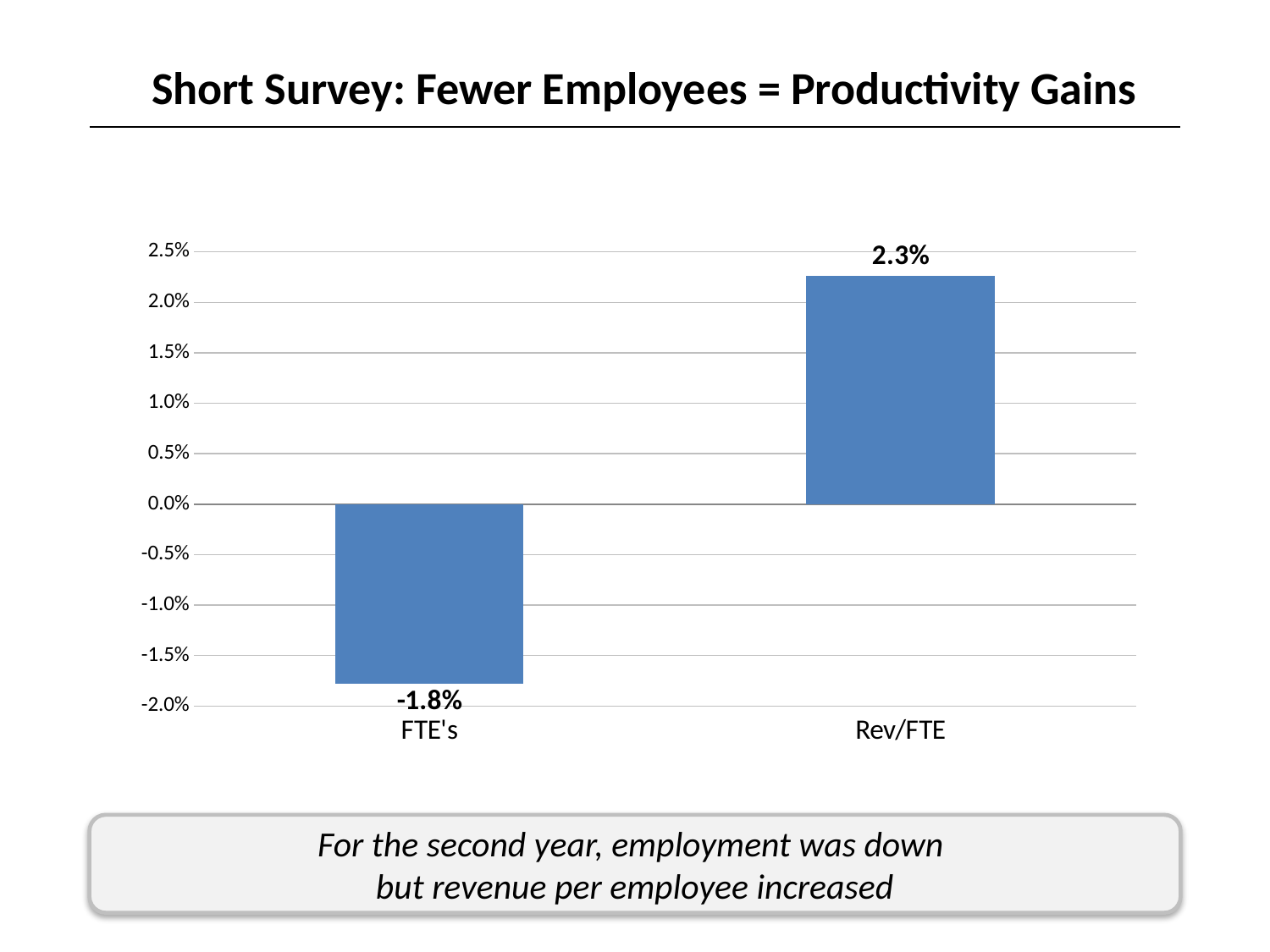
What is the highest value shown on the vertical axis? 2.5% Which category has the highest value? Rev/FTE Which category has the lowest value? FTE's What is the value for FTE's? -1.8% What is the value for Rev/FTE? 2.3% What kind of chart is shown on the slide? bar chart What is the difference between the Rev/FTE value and the FTE's value? 4.1% Is the value for Rev/FTE greater or less than 2.0%? greater What is the title of the slide containing the chart? Short Survey: Fewer Employees = Productivity Gains Which is larger, the value for FTE's or the value for Rev/FTE? Rev/FTE How many categories are shown on the chart? 2 Is the value for FTE's greater or less than 0.0%? less